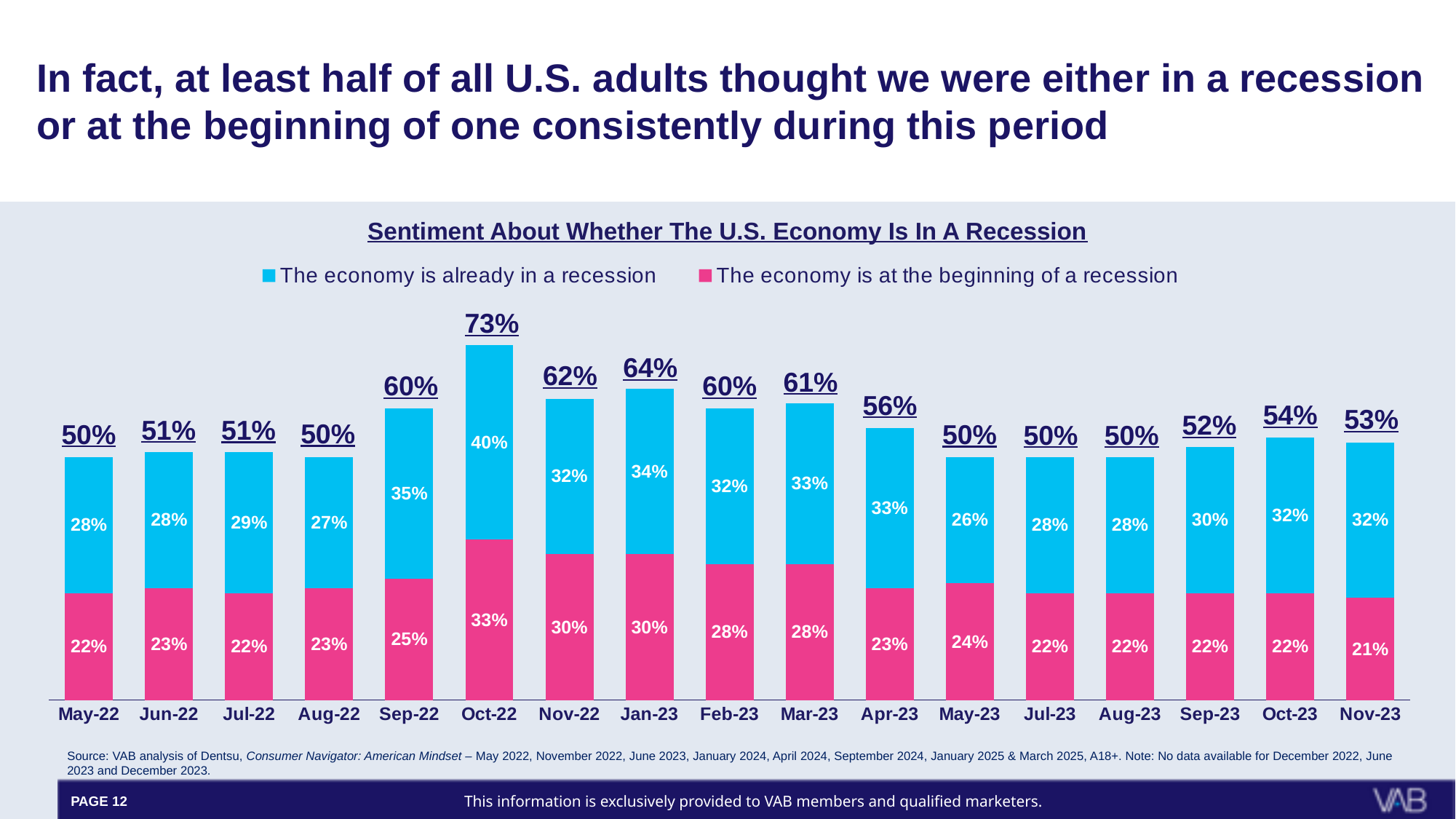
What is the title of the chart? Sentiment About Whether The U.S. Economy Is In A Recession Which month has the highest total stacked bar? Oct-22 What is the total of the stacked bar for Jan-23? 64% Which month has the lowest value for 'The economy is at the beginning of a recession'? Nov-23 What is the value for 'The economy is at the beginning of a recession' in Nov-22? 30% What is the difference between the total for Oct-22 and the total for Nov-22? 11% What is the difference between the 'already in a recession' value and the 'beginning of a recession' value in Mar-23? 5% Which is larger: the 'already in a recession' value for Sep-22 or for Apr-23? Sep-22 How many time periods are shown on the x axis? 17 How many series does the legend list? 2 What is the value for 'The economy is already in a recession' in Oct-22? 40% What type of chart is shown on the slide? Stacked bar chart